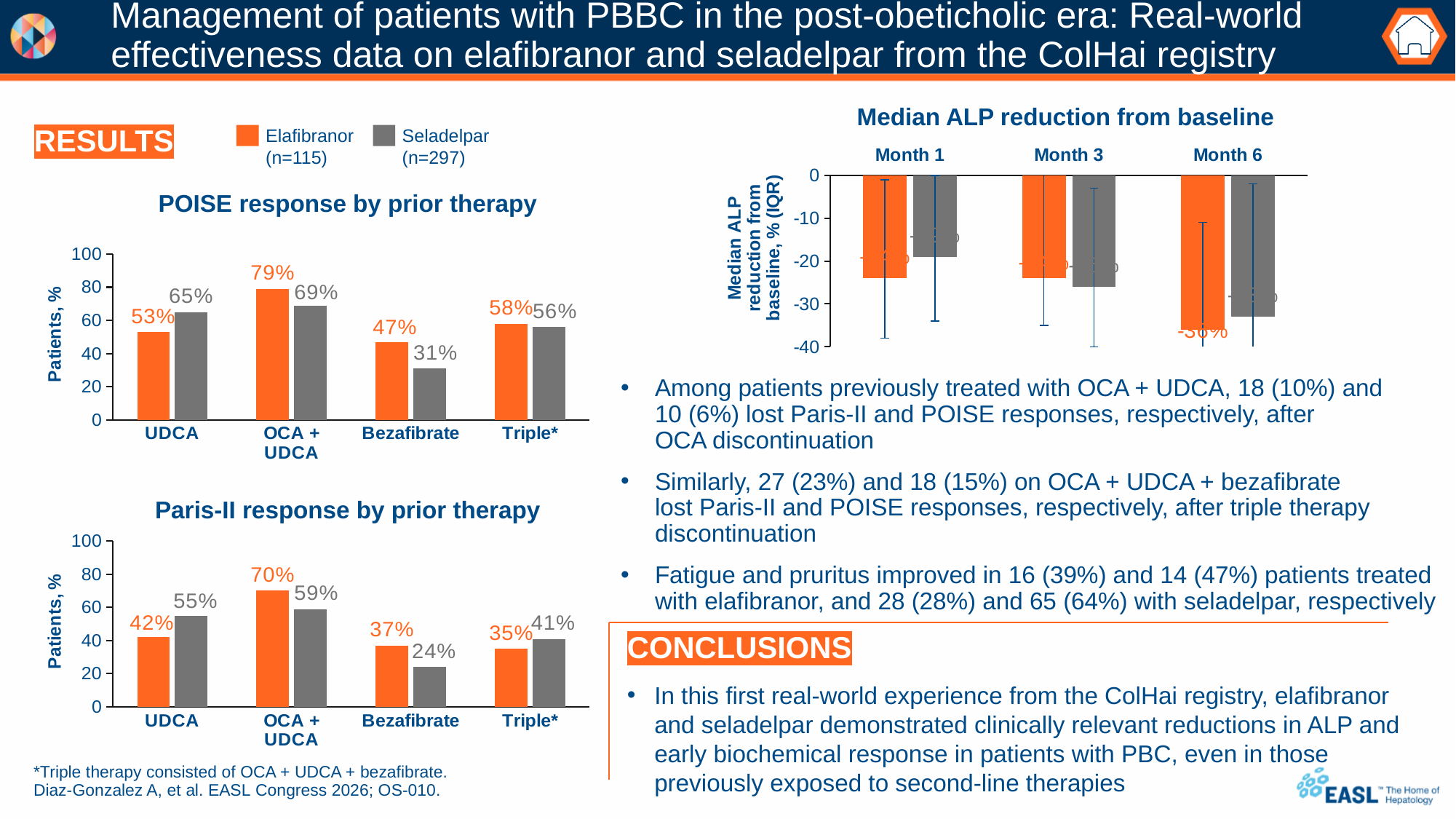
How many series does the legend list for the POISE response by prior therapy chart? 2 In the Paris-II response by prior therapy chart, is the Seladelpar value for UDCA greater or less than 40? greater In the Paris-II response by prior therapy chart, which prior therapy group has the lowest Seladelpar response? Bezafibrate What type of chart is the Median ALP reduction from baseline chart? Bar chart How many prior therapy categories are shown on the x axis of the Paris-II response by prior therapy chart? 4 In the Paris-II response by prior therapy chart, what is the value for Elafibranor in the Triple* group? 35% In the Paris-II response by prior therapy chart, what is the difference between Elafibranor and Seladelpar in the OCA + UDCA group? 11 percentage points In the POISE response by prior therapy chart, what is the difference between Elafibranor and Seladelpar in the Bezafibrate group? 16 percentage points In the POISE response by prior therapy chart, what is the value for Elafibranor in the OCA + UDCA group? 79% In the POISE response by prior therapy chart, which prior therapy group has the highest Elafibranor response? OCA + UDCA In the POISE response by prior therapy chart, what is the value for Seladelpar in the Bezafibrate group? 31% In the POISE response by prior therapy chart, which is larger in the UDCA group, Elafibranor or Seladelpar? Seladelpar